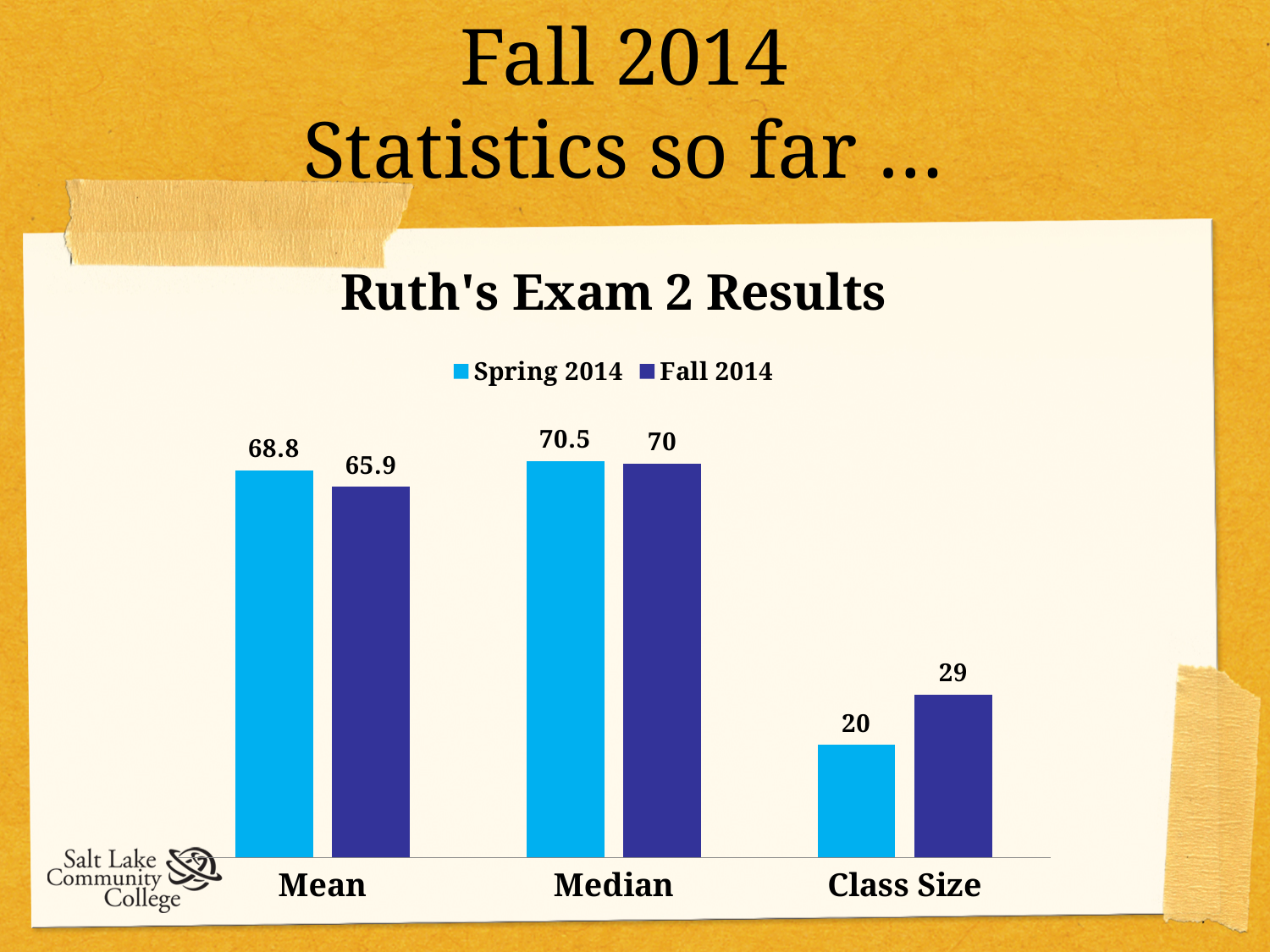
What is the Spring 2014 value for Mean? 68.8 What is the title of the chart? Ruth's Exam 2 Results How many categories are shown on the x axis? 3 Which is larger for Class Size, Spring 2014 or Fall 2014? Fall 2014 What is the Fall 2014 value for Class Size? 29 What is the Fall 2014 value for Mean? 65.9 What is the difference between the Spring 2014 and Fall 2014 values for Mean? 2.9 What is the Spring 2014 value for Median? 70.5 Which category has the highest Fall 2014 value? Median Which category has the lowest Spring 2014 value? Class Size What is the difference between the Fall 2014 and Spring 2014 values for Class Size? 9 How many series does the legend list? 2